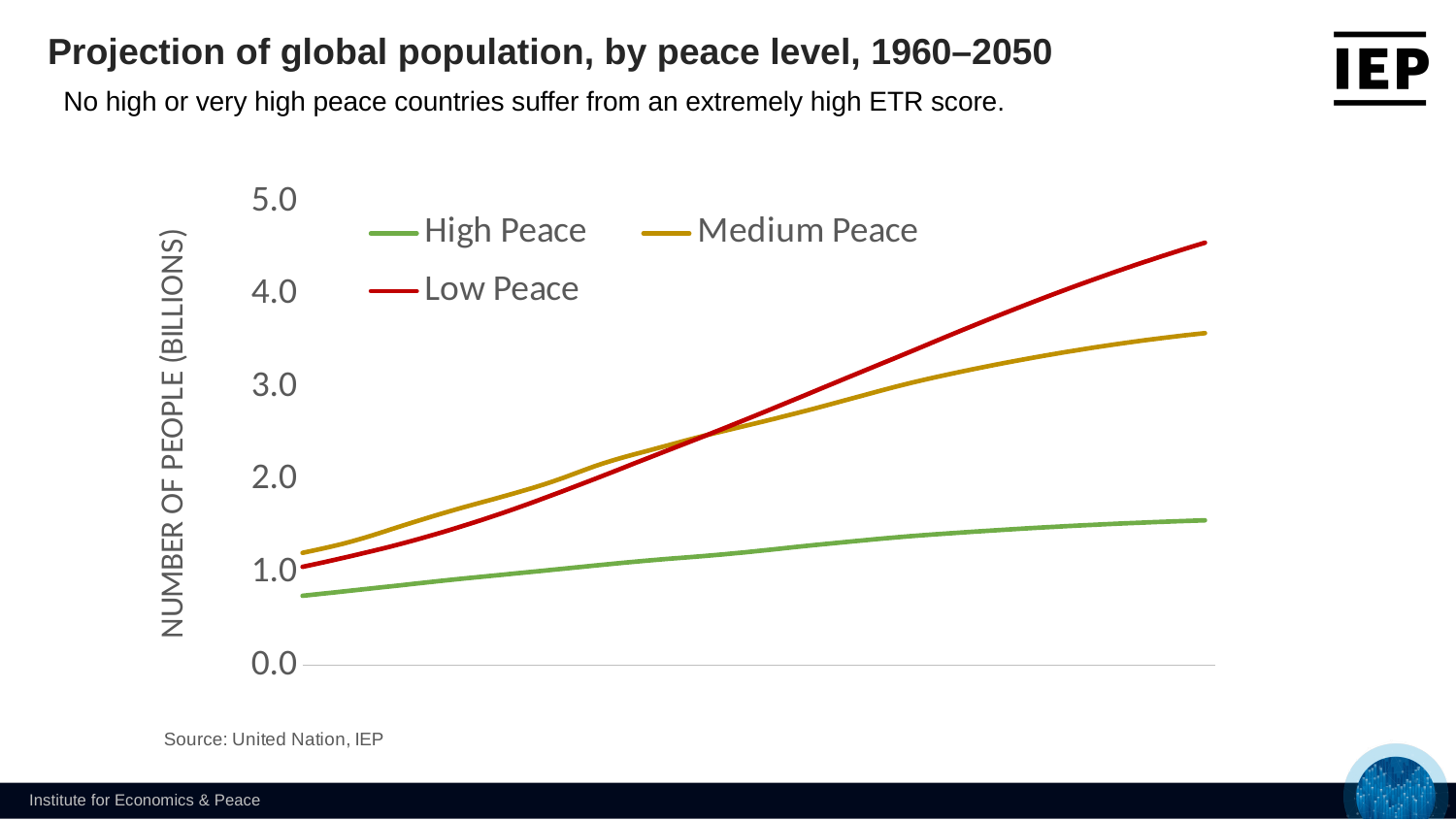
What kind of chart is shown on the slide? Line chart At the left end of the chart, which is larger: Medium Peace or High Peace? Medium Peace Is the value of the Medium Peace line at the right end of the chart greater or less than 3.0? greater What is the label of the vertical axis? NUMBER OF PEOPLE (BILLIONS) Which series reaches the highest value at the right end of the chart? Low Peace Does the High Peace line rise or fall from left to right? Rises Does the Low Peace line rise or fall from left to right? Rises Is the value of the High Peace line at the right end of the chart greater or less than 2.0? less Which series has the lowest values across the chart? High Peace Is the value of the Low Peace line at the right end of the chart greater or less than 4.0? greater At the right end of the chart, which is larger: Low Peace or Medium Peace? Low Peace How many series does the legend list? 3